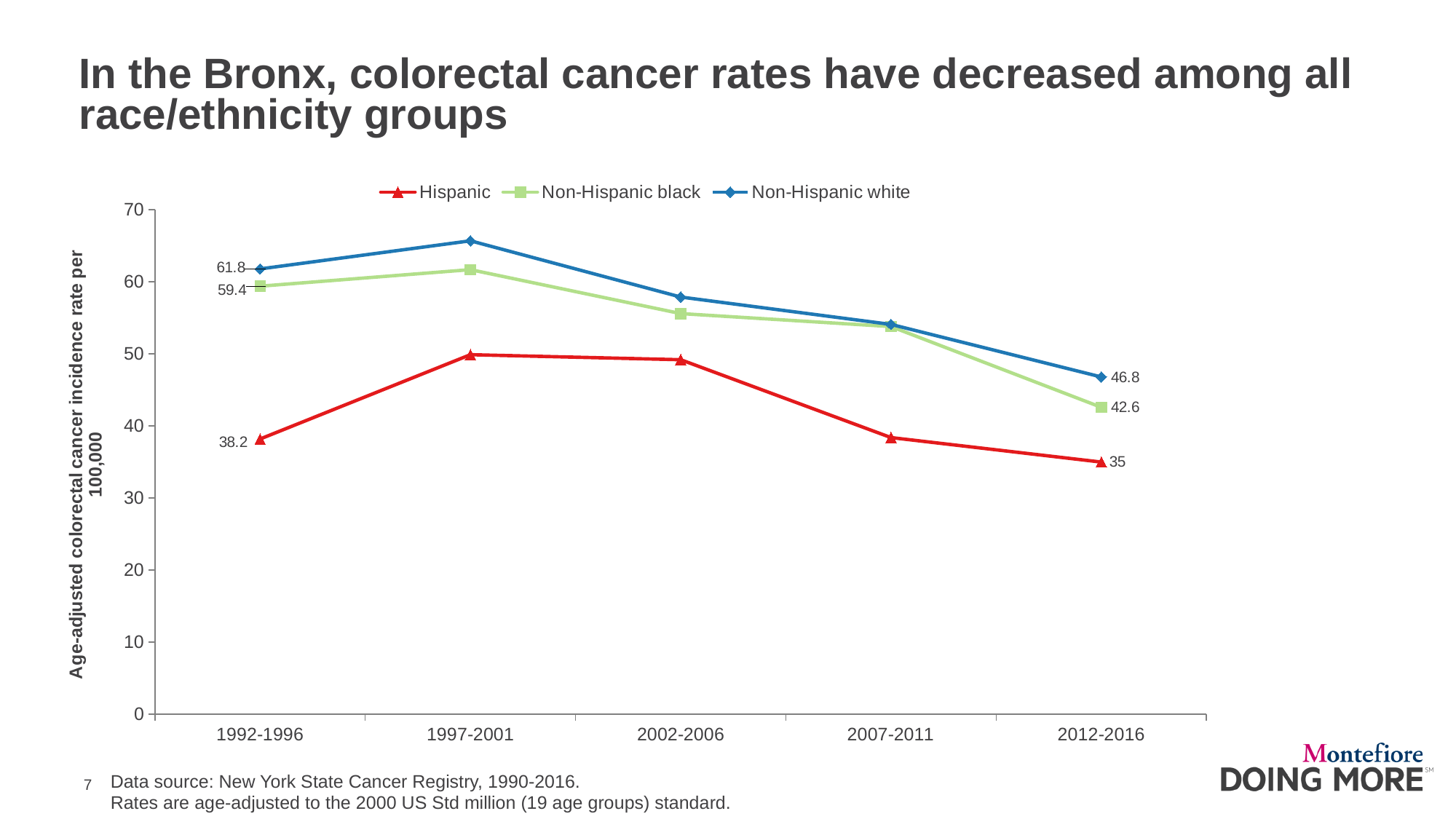
What is the difference between the Non-Hispanic black and Hispanic incidence rates in 2012-2016? 7.6 Is the Non-Hispanic white incidence rate for 1997-2001 greater or less than 60? greater Which race/ethnicity group has the highest incidence rate in 1992-1996? Non-Hispanic white Which race/ethnicity group has the lowest incidence rate in 2012-2016? Hispanic What is the colorectal cancer incidence rate for Non-Hispanic white residents in 2012-2016? 46.8 How many series does the legend list? 3 What is the colorectal cancer incidence rate for Hispanic residents in 1992-1996? 38.2 What is the colorectal cancer incidence rate for Hispanic residents in 2012-2016? 35 By how much did the Non-Hispanic white incidence rate fall from 1992-1996 to 2012-2016? 15 What is the colorectal cancer incidence rate for Non-Hispanic black residents in 1992-1996? 59.4 What kind of chart is shown on the slide? Line chart In 2012-2016, is the incidence rate higher for Non-Hispanic black or Non-Hispanic white residents? Non-Hispanic white